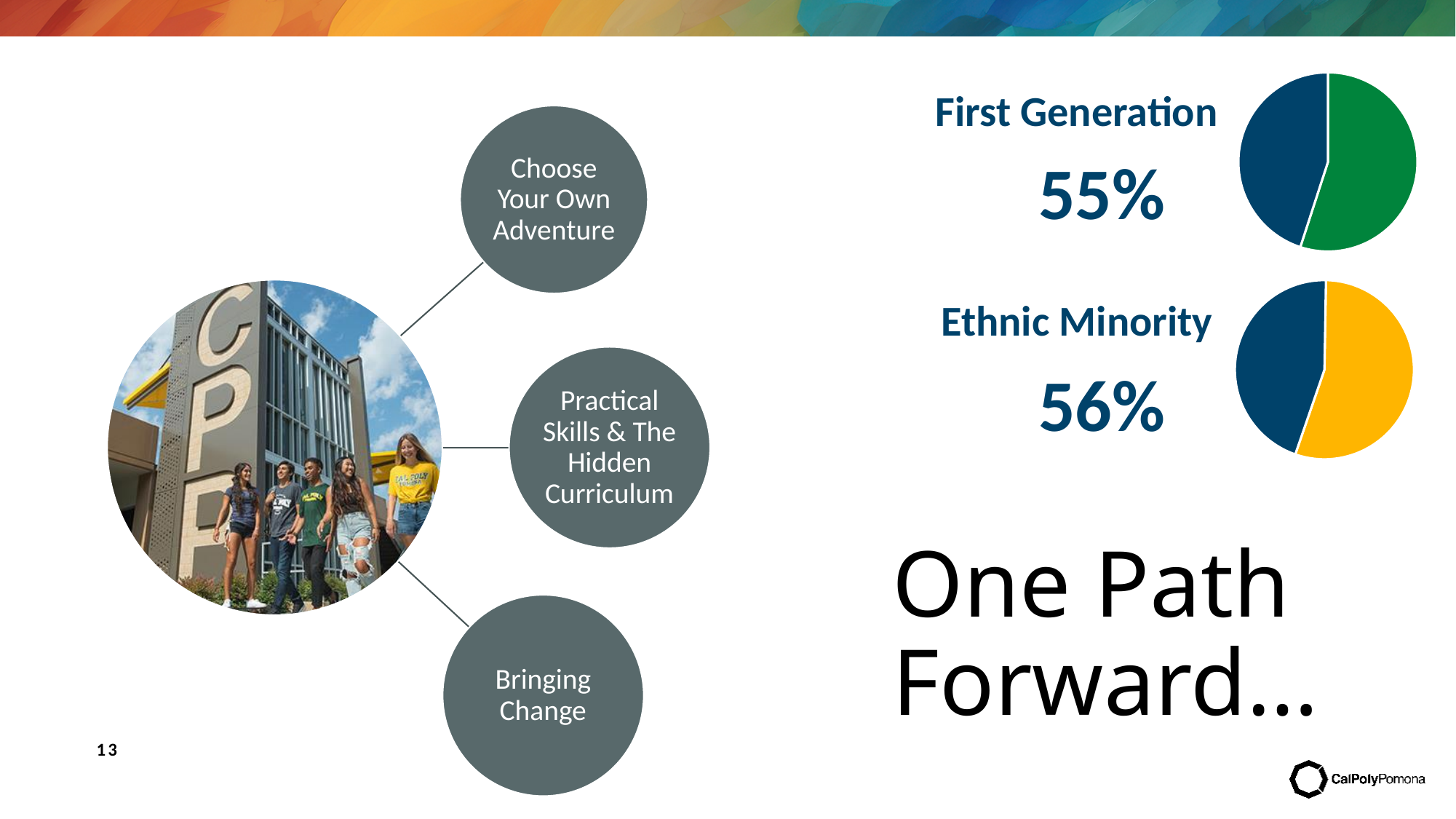
What kind of chart is used to show the Ethnic Minority figure? pie chart Which is larger, the First Generation percentage or the Ethnic Minority percentage? Ethnic Minority In the First Generation pie chart, what percentage is shown? 55% How many slices does the Ethnic Minority pie chart have? 2 In the Ethnic Minority pie chart, what colour is the larger slice? yellow In the First Generation pie chart, what colour is the larger slice? green What is the difference between the Ethnic Minority percentage and the First Generation percentage? 1% Is the First Generation percentage greater or less than 50%? greater Is the Ethnic Minority percentage greater or less than 50%? greater How many slices does the First Generation pie chart have? 2 In the Ethnic Minority pie chart, what percentage is shown? 56% What kind of chart is used to show the First Generation figure? pie chart